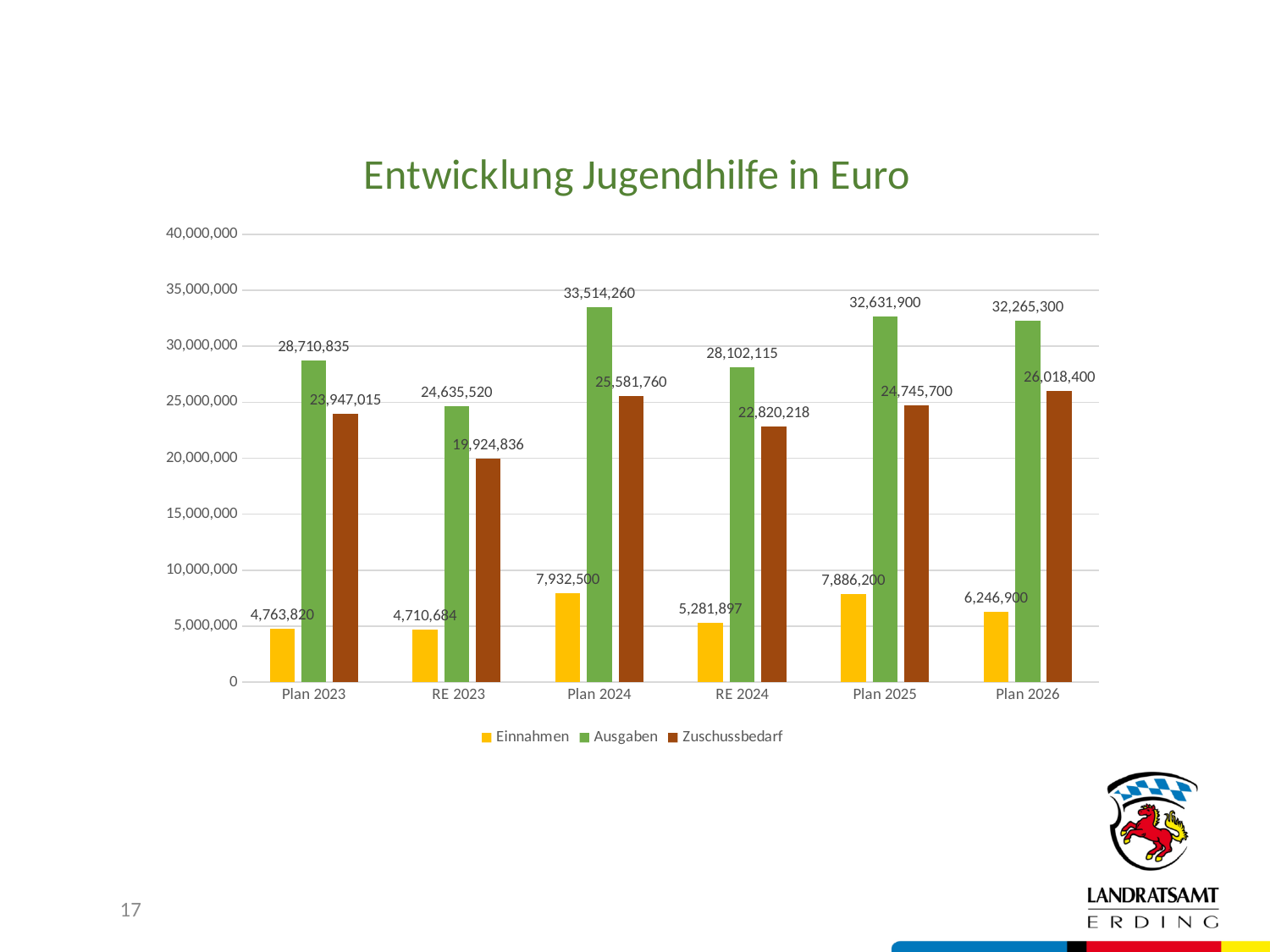
What kind of chart is shown on the slide? bar chart What is the Einnahmen value for RE 2024? 5,281,897 Is the Einnahmen value for Plan 2024 greater or less than 5,000,000? greater How many categories are shown on the x axis? 6 What is the Ausgaben value for Plan 2024? 33,514,260 Which is larger: the Einnahmen value for Plan 2024 or for Plan 2025? Plan 2024 What is the difference between the Ausgaben values for Plan 2025 and Plan 2026? 366,600 How many series does the legend list? 3 Which category has the highest Ausgaben value? Plan 2024 Which category has the lowest Zuschussbedarf value? RE 2023 What is the Zuschussbedarf value for Plan 2026? 26,018,400 What is the title of the chart? Entwicklung Jugendhilfe in Euro